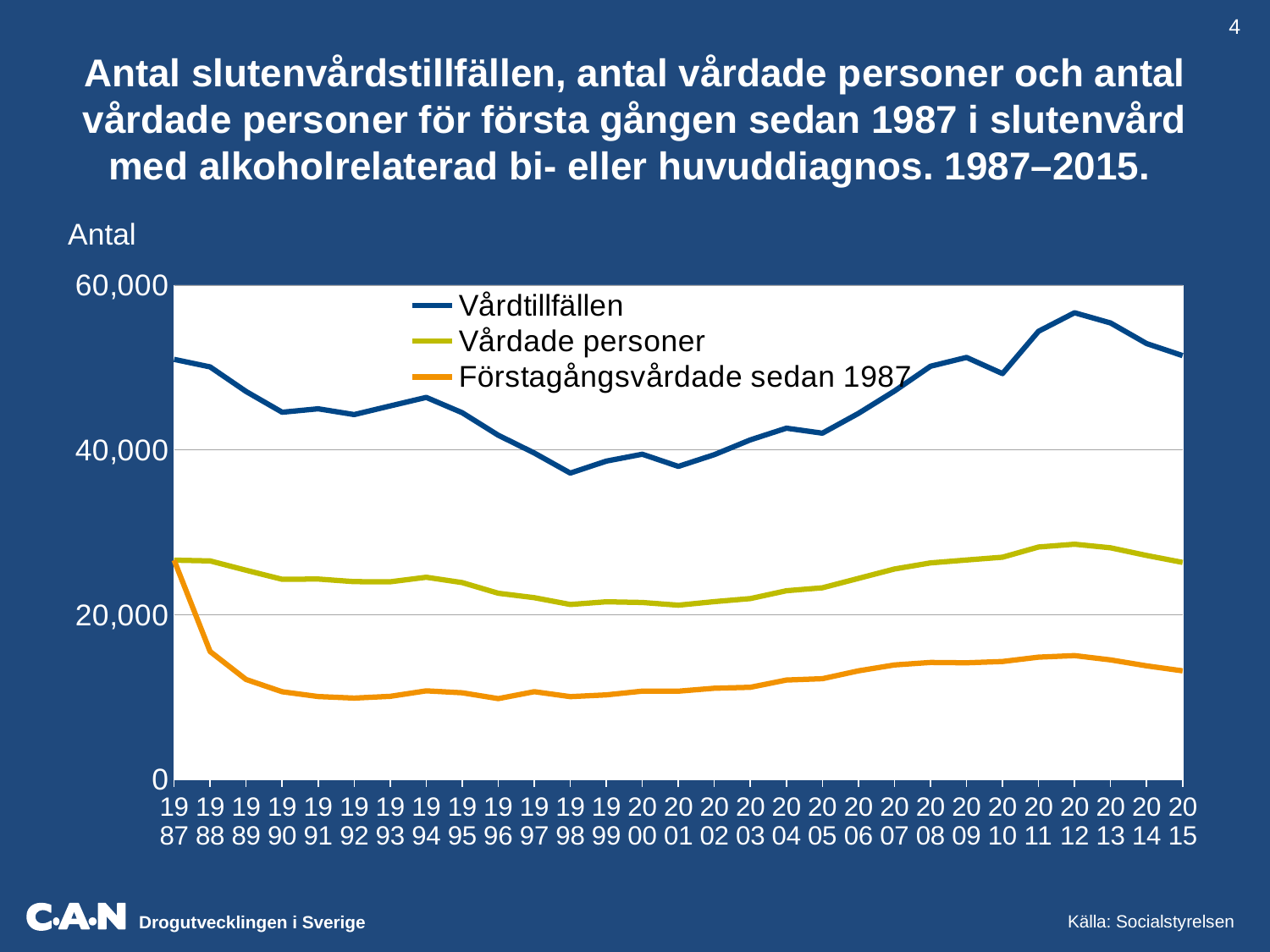
What kind of chart is shown on the slide? line chart In which year is the Förstagångsvårdade sedan 1987 series at its highest? 1987 In which year does the Vårdtillfällen series reach its lowest value? 1998 Is the value for Vårdtillfällen in 1998 greater or less than 40,000? less Which is larger, Vårdtillfällen in 2012 or Vårdtillfällen in 1987? 2012 Does the Förstagångsvårdade sedan 1987 series rise or fall between 1987 and 1990? fall Is the value for Vårdade personer in 2012 greater or less than 20,000? greater How many years are plotted along the x axis? 29 Which series is shown in orange? Förstagångsvårdade sedan 1987 How many series does the legend list? 3 In which year does the Vårdtillfällen series reach its highest value? 2012 What label is shown above the y axis? Antal